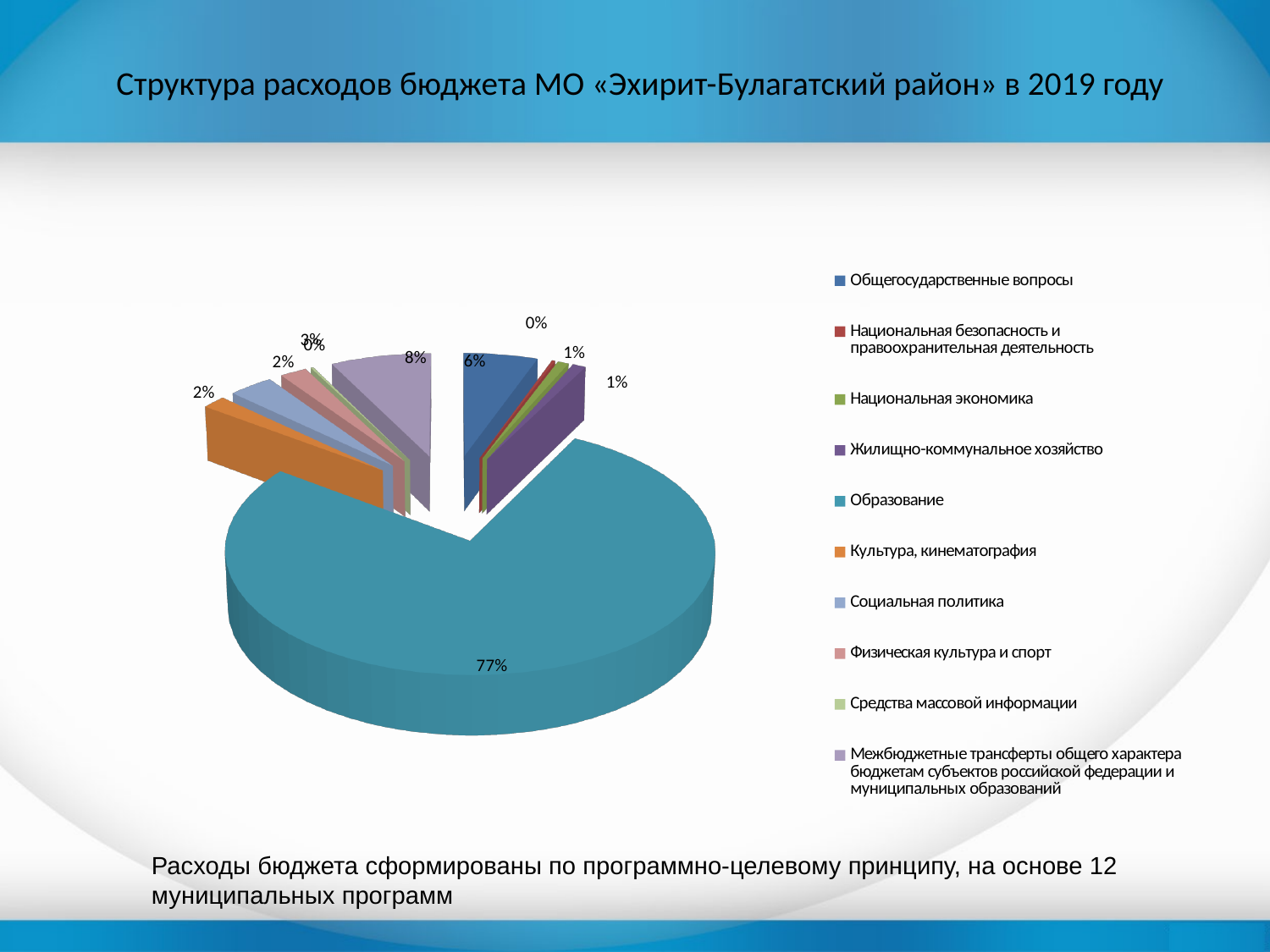
What share of the pie does Национальная безопасность и правоохранительная деятельность account for? 0% How many categories does the legend list? 10 What is the title of the slide containing the chart? Структура расходов бюджета МО «Эхирит-Булагатский район» в 2019 году Which slice is larger: Общегосударственные вопросы or Межбюджетные трансферты общего характера? Межбюджетные трансферты общего характера What share of the pie does Жилищно-коммунальное хозяйство account for? 1% What is the difference in percentage points between the Образование slice and the Межбюджетные трансферты slice? 69 percentage points What share of the pie does Межбюджетные трансферты общего характера бюджетам субъектов российской федерации и муниципальных образований account for? 8% What share of the pie does Общегосударственные вопросы account for? 6% What kind of chart is shown on the slide? Pie chart What share of the pie does Культура, кинематография account for? 2% What share of the pie does Образование account for? 77% Which category has the largest slice of the pie? Образование